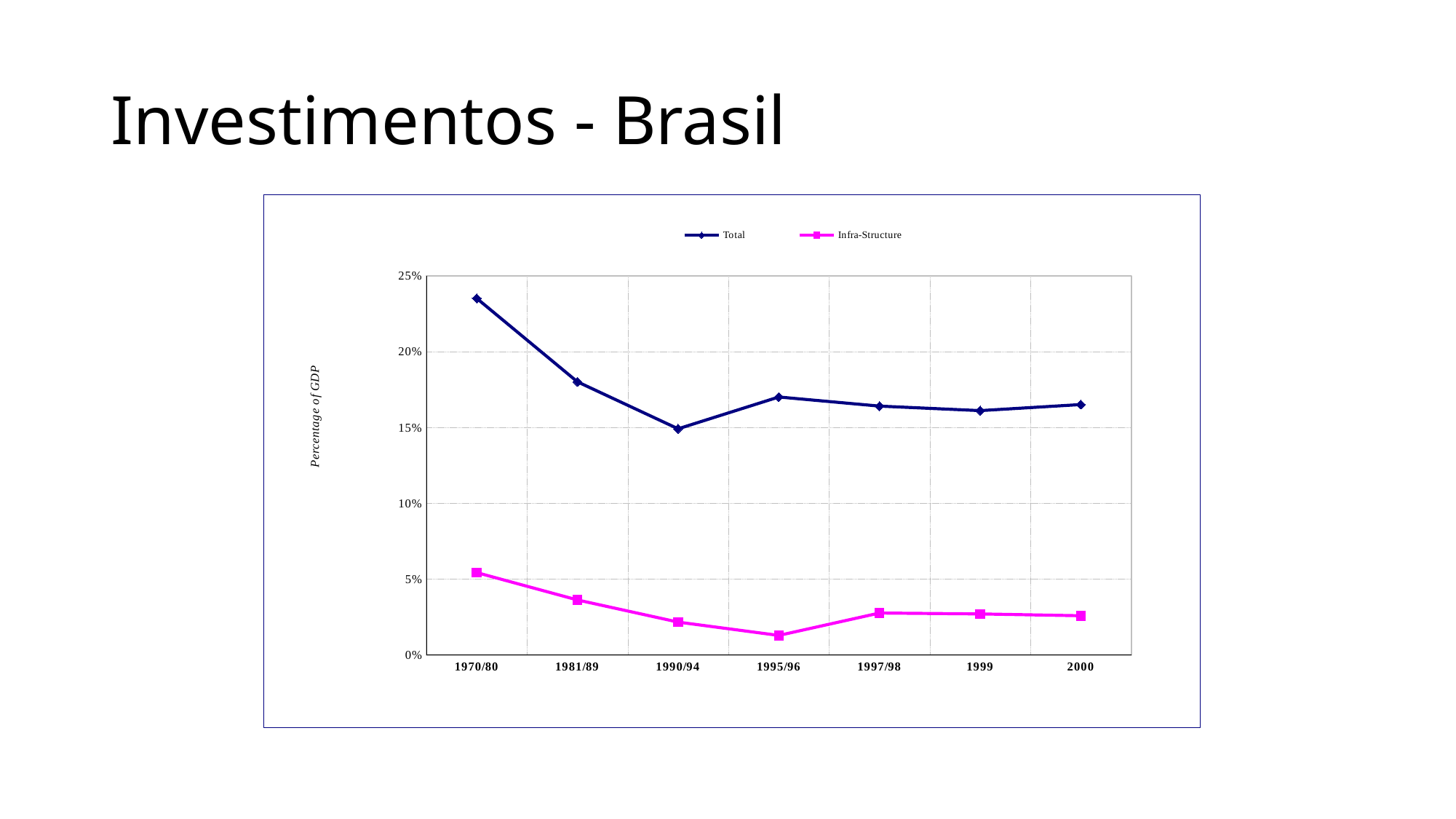
In which period is the Infra-Structure series at its highest? 1970/80 In which period is the Total series at its highest? 1970/80 In which period is the Total series at its lowest? 1990/94 How many periods are shown along the x axis? 7 How many series does the legend list? 2 In which period is the Infra-Structure series at its lowest? 1995/96 Is the Total value for 1981/89 greater or less than 20%? less What kind of chart is shown on the slide? line chart Is the Total value for 1970/80 greater or less than 20%? greater Is the Infra-Structure value for 1995/96 greater or less than 5%? less What is the label on the vertical axis? Percentage of GDP Does the Total series rise or fall from 1970/80 to 1990/94? fall